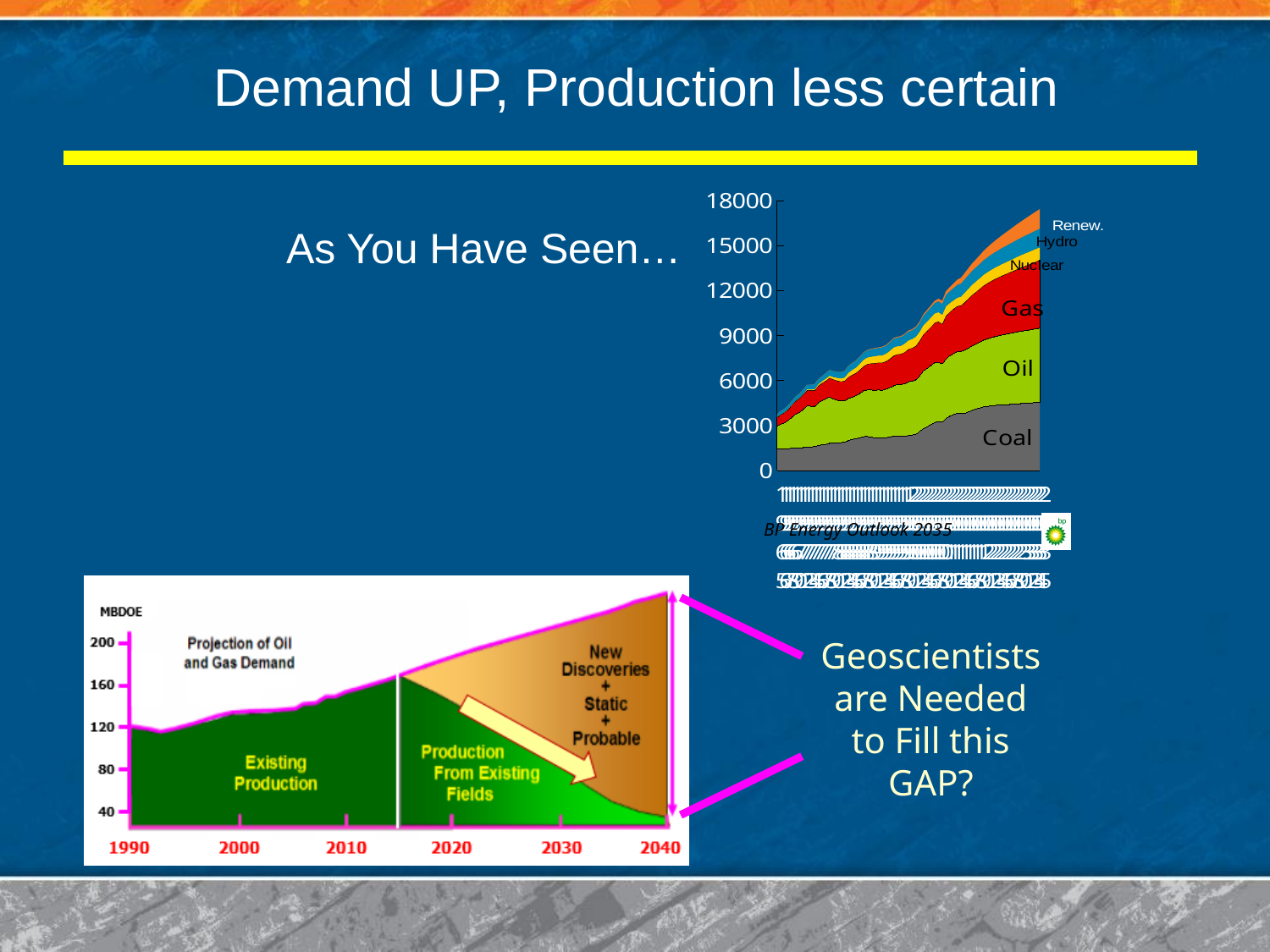
On the bottom-left chart, does the projected oil and gas demand line rise or fall from 1990 to 2040? Rises On the BP Energy Outlook 2035 chart, is the top of the Coal band at the right-hand end greater or less than 6000? less What kind of chart is the BP Energy Outlook 2035 chart on the right of the slide? Stacked area chart How many energy series are labelled on the BP Energy Outlook 2035 chart? 6 On the BP Energy Outlook 2035 chart, does total energy rise or fall from left to right along the x axis? Rises On the bottom-left chart, is production from existing fields in 2040 greater or less than 80 MBDOE? less On the BP Energy Outlook 2035 chart, is the total at the right-hand end greater or less than 15000? greater On the BP Energy Outlook 2035 chart, which series is at the bottom of the stack? Coal On the bottom-left chart, how many year labels are shown on the x axis? 6 What is the highest value shown on the y axis of the BP Energy Outlook 2035 chart? 18000